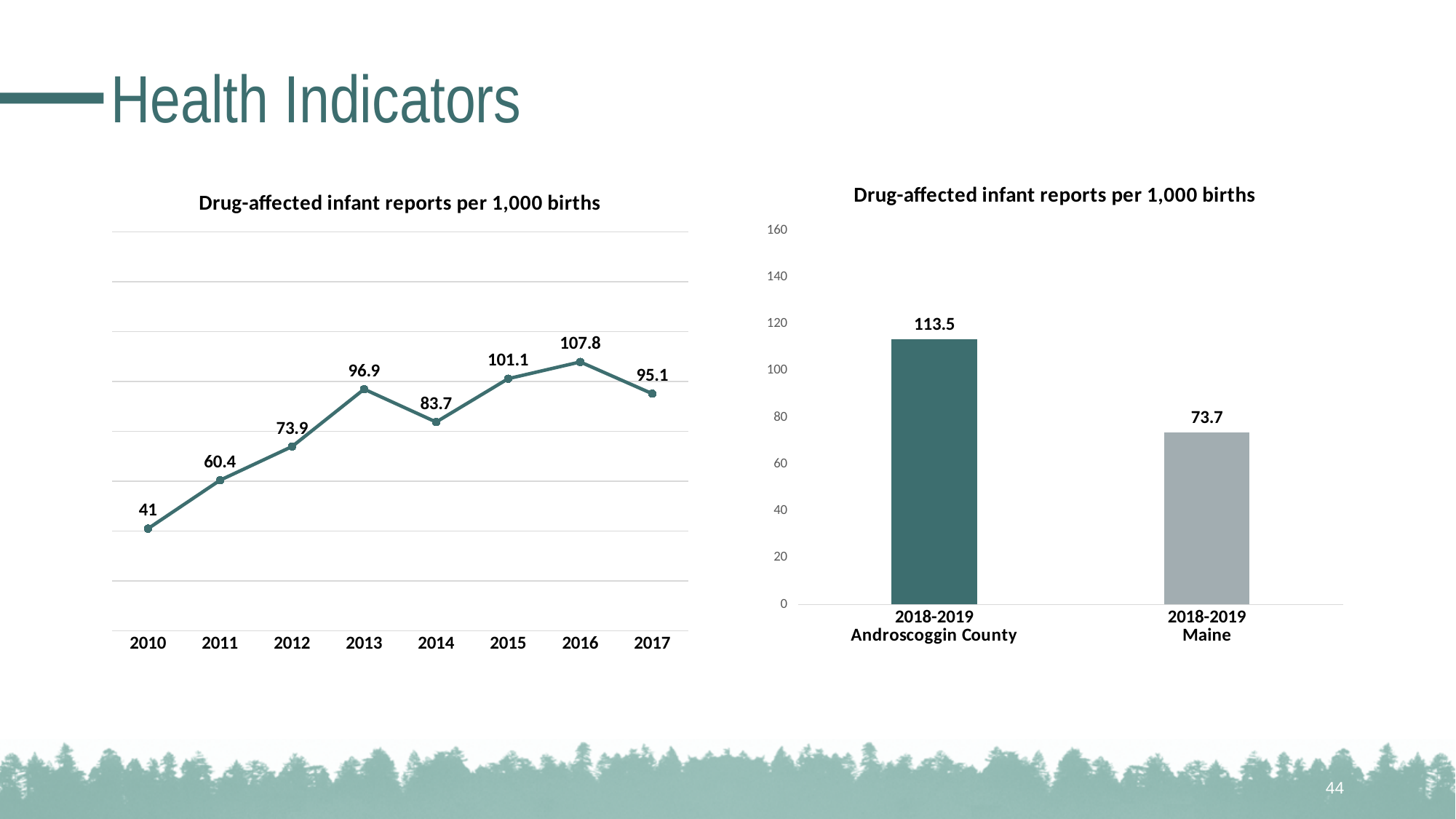
In the line chart on the left, what is the difference between the values for 2016 and 2017? 12.7 In the line chart on the left, which is larger, the value for 2014 or the value for 2015? 2015 In the bar chart on the right, what is the difference between the Androscoggin County value and the Maine value? 39.8 In the line chart on the left, which year has the highest value? 2016 In the line chart on the left, what is the value for 2013? 96.9 In the line chart on the left, how many years are plotted? 8 In the line chart on the left, does the value rise or fall from 2010 to 2013? Rise In the bar chart on the right, is the value for 2018-2019 Maine greater or less than 80? less In the line chart on the left, what is the value for 2010? 41 In the line chart on the left, which year has the lowest value? 2010 What kind of chart is shown on the left side of the slide? Line chart In the bar chart on the right, what is the value for 2018-2019 Androscoggin County? 113.5